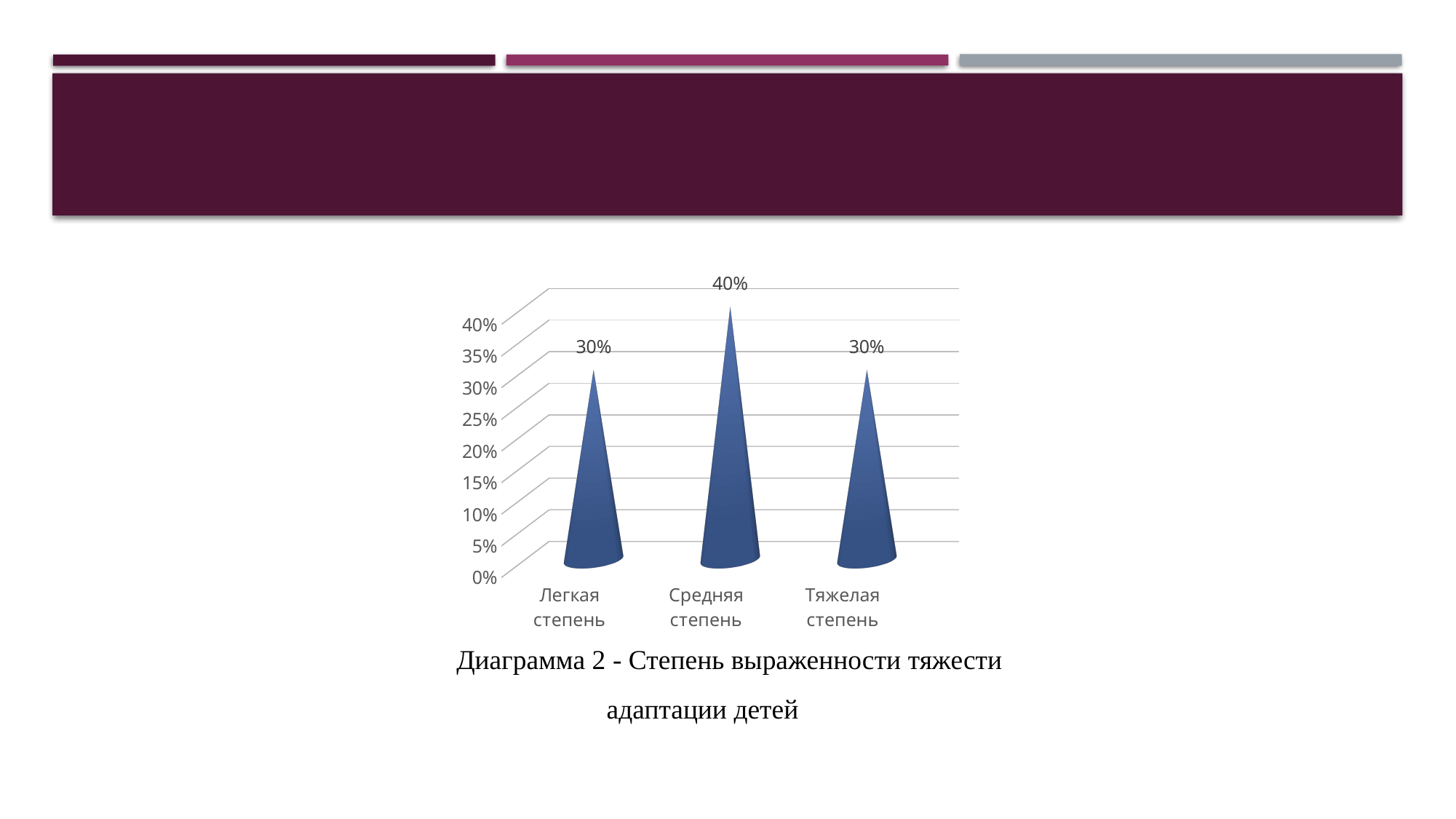
Is the value for Легкая степень greater or less than 35%? less What is the value for Легкая степень? 30% Is the value for Средняя степень greater or less than 35%? greater What kind of chart is shown on the slide? bar chart What is the value for Тяжелая степень? 30% Which category has the highest value? Средняя степень Which is larger, the value for Средняя степень or the value for Тяжелая степень? Средняя степень What is the difference between the values for Средняя степень and Легкая степень? 10% What is the caption printed below the chart? Диаграмма 2 - Степень выраженности тяжести адаптации детей How many categories are shown on the x axis? 3 What is the value for Средняя степень? 40% What is the highest value shown on the vertical axis? 40%